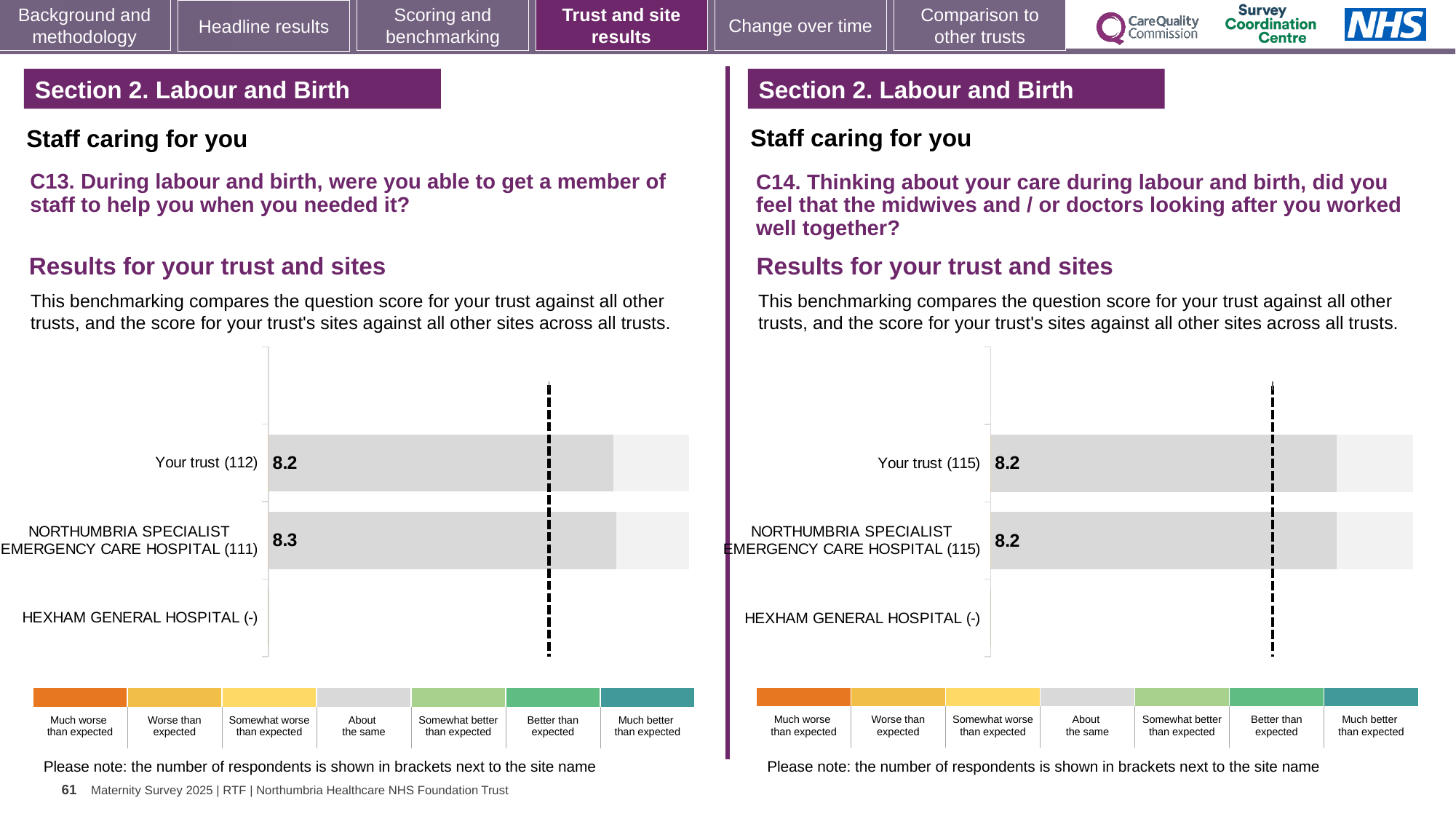
On the C14 chart (right), which category has no score bar shown? Hexham General Hospital (-) On the C13 chart (left), how many categories does the colour key below the chart list? 7 On the C13 chart (left), how many categories are listed on the vertical axis? 3 On the C13 chart (left), how many respondents are shown in brackets for Northumbria Specialist Emergency Care Hospital? 111 What kind of chart is used on the C14 chart (right)? Bar chart On the C13 chart (left), how many respondents are shown in brackets for Your trust? 112 On the C13 chart (left), what is the difference between the score for Northumbria Specialist Emergency Care Hospital and the score for Your trust? 0.1 On the C14 chart (right), what is the score for Your trust? 8.2 On the C13 chart (left), what is the score for Northumbria Specialist Emergency Care Hospital? 8.3 On the C14 chart (right), what is the score for Northumbria Specialist Emergency Care Hospital? 8.2 On the C13 chart (left), what is the score for Your trust? 8.2 On the C14 chart (right), how many respondents are shown in brackets for Northumbria Specialist Emergency Care Hospital? 115